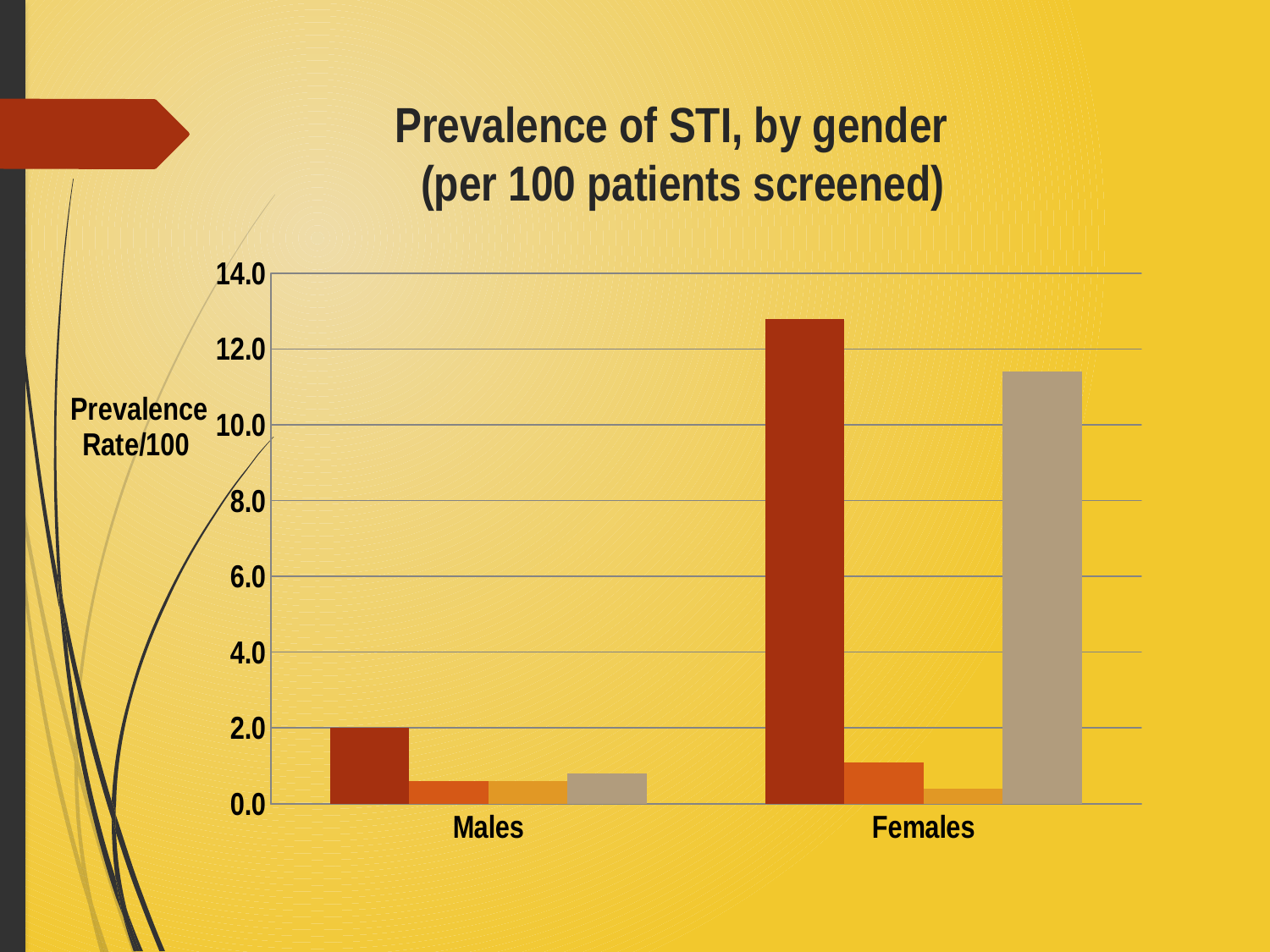
Is the value of the tan bar for Females greater or less than 10.0? greater Is the value of the orange bar for Males greater or less than 2.0? less How many categories are shown on the x axis of the chart? 2 What kind of chart is shown on the slide? bar chart What is the title of the chart? Prevalence of STI, by gender (per 100 patients screened) Is the value of the dark red bar for Females greater or less than 12.0? greater Which is larger: the dark red bar for Males or the dark red bar for Females? the dark red bar for Females For Females, which is larger: the dark red bar or the tan bar? the dark red bar What is the label on the vertical axis of the chart? Prevalence Rate/100 Which category, Males or Females, has the tallest bar in the chart? Females How many bars are plotted for the Males category? 4